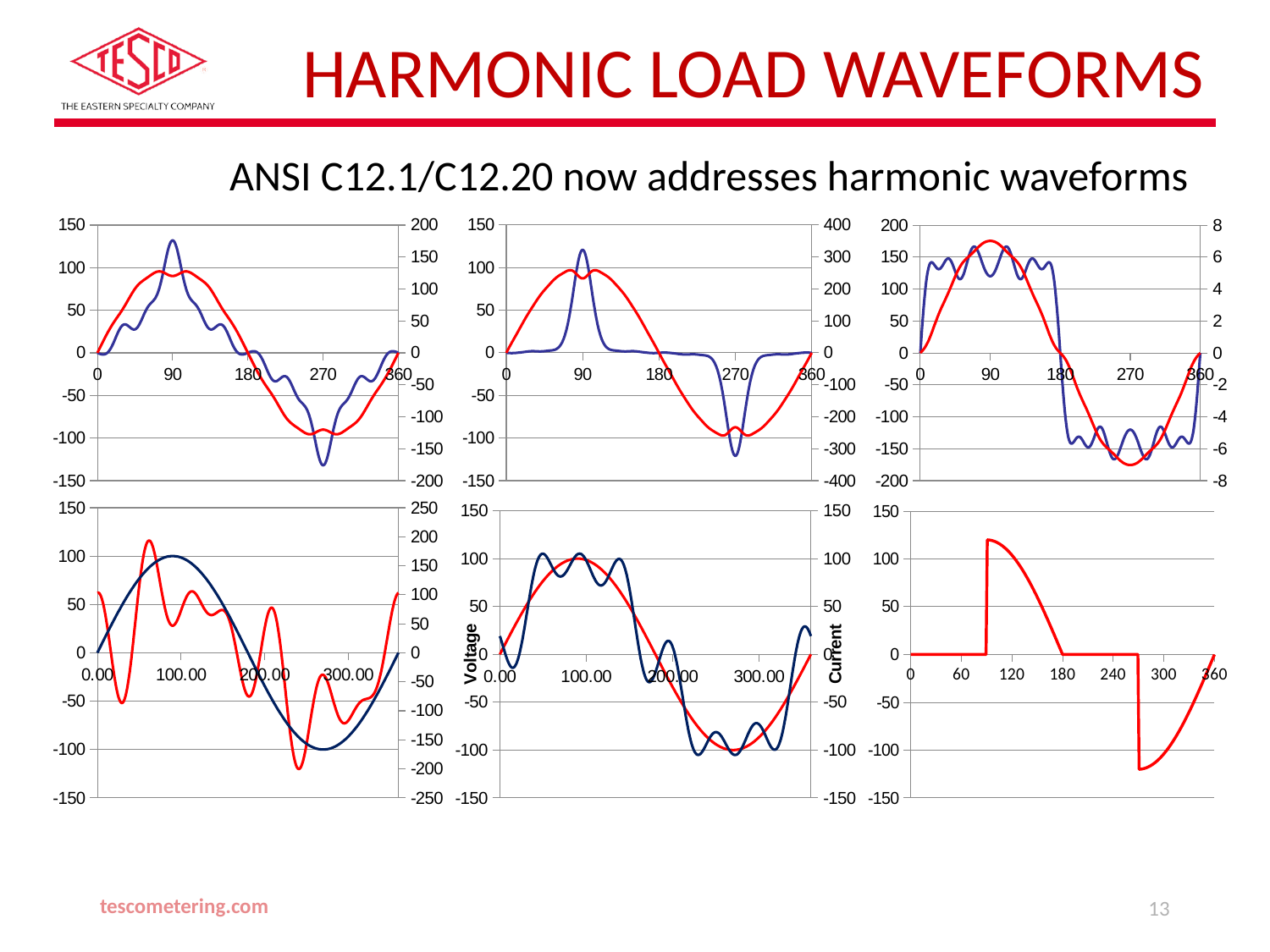
In the top-left chart, does the red line rise or fall between x = 90 and x = 270? fall In the bottom-right chart, how many lines are plotted? 1 In the bottom-right chart, is the peak value of the red line greater or less than 100? greater In the bottom-right chart, is the lowest value of the red line greater or less than -100? less In the bottom-middle chart, what is the title of the right vertical axis? Current In the bottom-right chart, does the red line rise or fall between x = 120 and x = 180? fall What kind of charts are shown on the slide? Line charts In the bottom-middle chart, what is the title of the left vertical axis? Voltage In the bottom-right chart, is the value of the red line at x = 60 greater or less than 50? less In the top-left chart, does the red line rise or fall between x = 0 and x = 90? rise How many charts are shown on the slide? 6 In the top-left chart, how many lines are plotted? 2